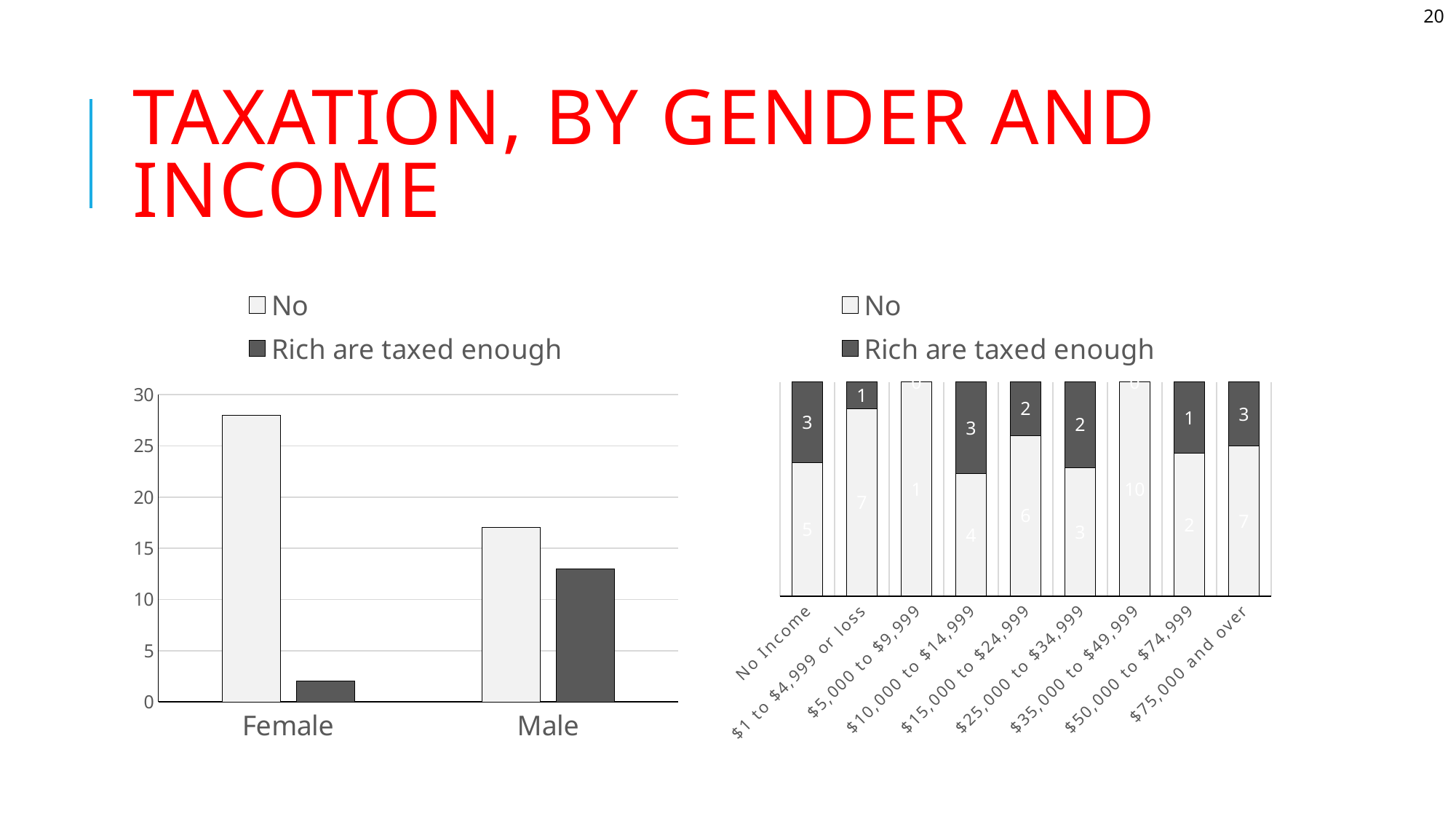
In the left chart (by gender), is the 'Rich are taxed enough' value for Female greater or less than 5? less In the left chart (by gender), which has the larger 'No' value, Female or Male? Female In the right chart (by income), what is the 'No' value for $75,000 and over? 7 In the left chart (by gender), is the 'Rich are taxed enough' value for Male greater or less than 10? greater In the right chart (by income), what is the 'Rich are taxed enough' value for No Income? 3 In the right chart (by income), what is the 'Rich are taxed enough' value for $15,000 to $24,999? 2 How many series does the legend of the left chart (by gender) list? 2 In the left chart (by gender), is the 'No' value for Female greater or less than 25? greater How many income categories are shown on the x axis of the right chart (by income)? 9 What kind of chart is the left chart (by gender)? bar chart What are the two legend entries of the right chart (by income)? No; Rich are taxed enough In the right chart (by income), what is the total of the No Income bar (No plus Rich are taxed enough)? 8